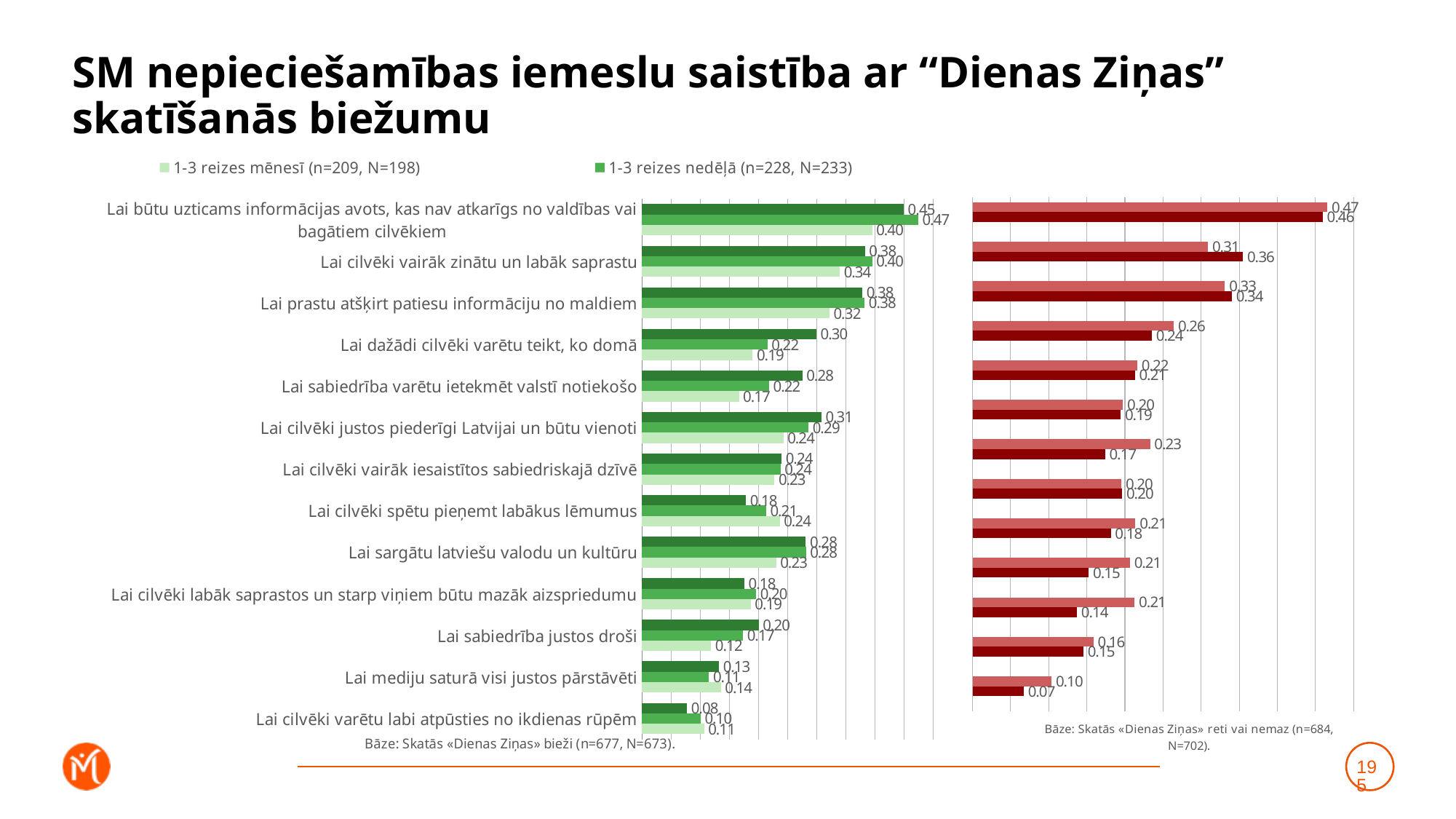
On the left (green) chart, which is larger for the '1-3 reizes mēnesī' (lightest green) series: 'Lai sabiedrība justos droši' or 'Lai mediju saturā visi justos pārstāvēti'? Lai mediju saturā visi justos pārstāvēti On the left (green) chart, what is the value of the '1-3 reizes mēnesī' (lightest green) bar for 'Lai būtu uzticams informācijas avots, kas nav atkarīgs no valdības vai bagātiem cilvēkiem'? 0.40 On the right (red) chart, what is the difference between the lighter red bar (0.23) and the darker red bar (0.17) for 'Lai cilvēki vairāk iesaistītos sabiedriskajā dzīvē'? 0.06 What kind of chart is shown on the left (green) side of the slide? bar chart On the right (red) chart, what is the lowest value shown for the darker red (bottom) bars? 0.07 How many series does the legend at the top of the slide list? 2 On the left (green) chart, what is the value of the '1-3 reizes mēnesī' (lightest green) bar for 'Lai sabiedrība justos droši'? 0.12 On the right (red) chart, which category has the highest value? Lai būtu uzticams informācijas avots, kas nav atkarīgs no valdības vai bagātiem cilvēkiem What base (Bāze) is stated below the right (red) chart? Skatās «Dienas Ziņas» reti vai nemaz (n=684, N=702) How many categories (reasons) are listed on the left (green) chart? 13 On the right (red) chart, what is the difference between the darker red bar (0.36) and the lighter red bar (0.31) for 'Lai cilvēki vairāk zinātu un labāk saprastu'? 0.05 On the right (red) chart, what is the value of the lighter red (top) bar for 'Lai cilvēki varētu labi atpūsties no ikdienas rūpēm'? 0.10